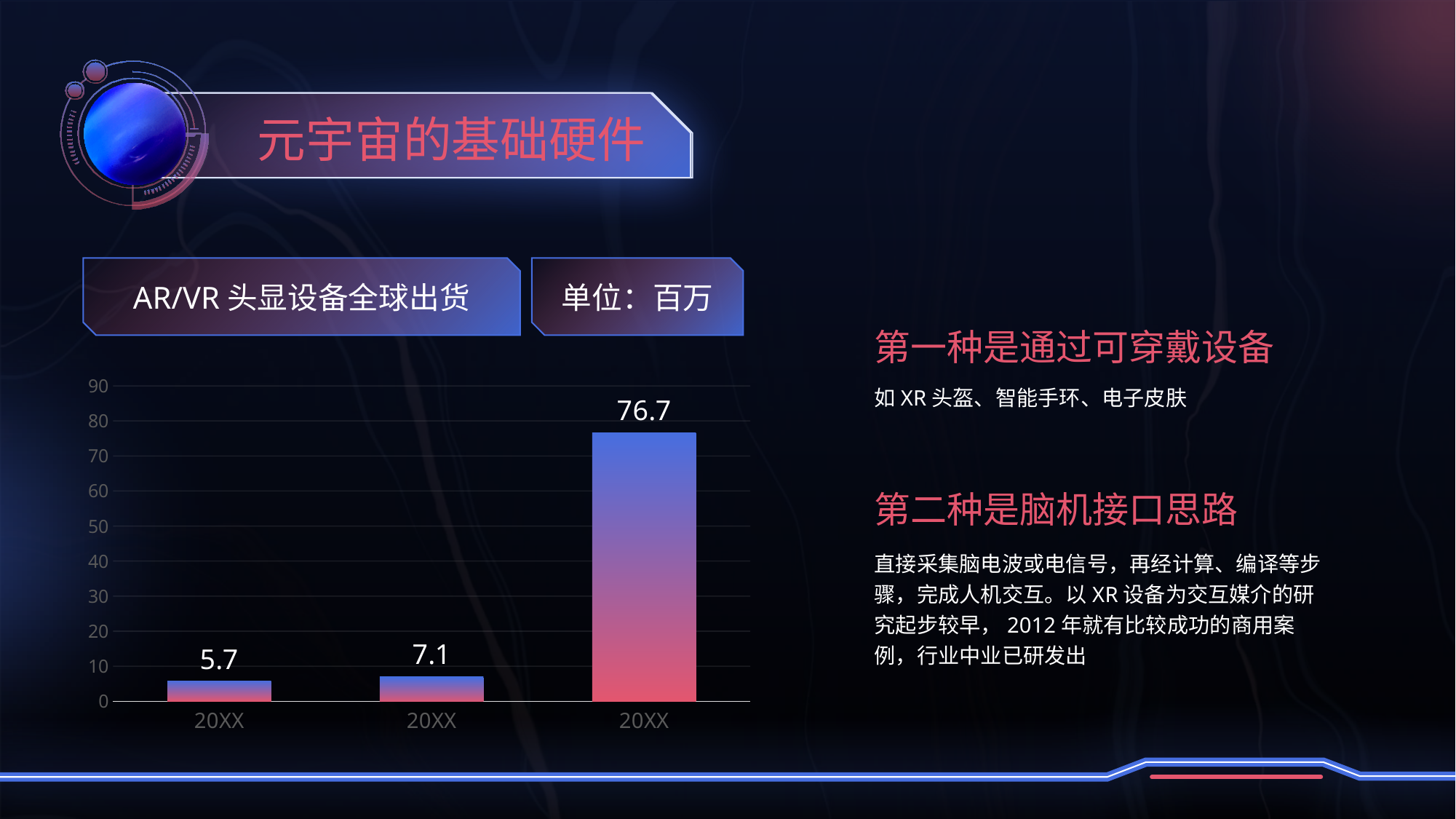
What is the difference between the second bar (7.1) and the first bar (5.7)? 1.4 Which bar has the highest value in the chart? The third (rightmost) bar, 76.7 Is the value of the third bar greater or less than 70? greater Which is larger, the first bar or the second bar? The second bar What is the value of the second (middle) bar in the chart? 7.1 Which bar has the lowest value in the chart? The first (leftmost) bar, 5.7 What is the difference between the third bar (76.7) and the second bar (7.1)? 69.6 What is the value of the first (leftmost) bar in the chart? 5.7 Do the values rise or fall from left to right along the x axis? Rise What kind of chart is shown on the slide? Bar chart How many bars are plotted in the chart? 3 What is the value of the third (rightmost) bar in the chart? 76.7